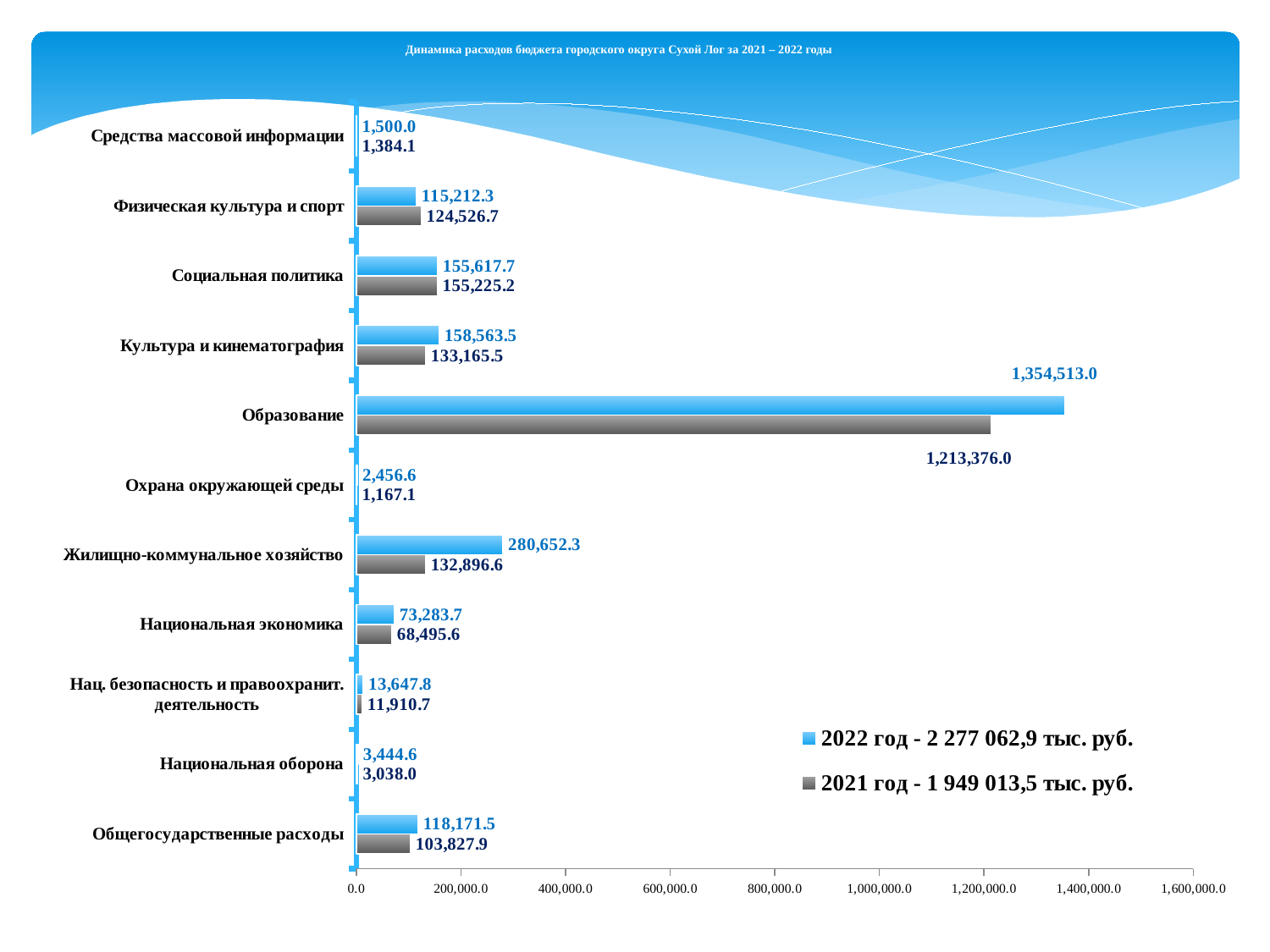
What is the 2022 value for Национальная оборона? 3,444.6 What is the 2021 value for Жилищно-коммунальное хозяйство? 132,896.6 Which category has the lowest 2021 value? Охрана окружающей среды How many categories are plotted on the chart? 11 What type of chart is shown on the slide? bar chart What total amount does the legend give for 2022 год? 2 277 062,9 тыс. руб. For Физическая культура и спорт, which year has the larger value, 2022 or 2021? 2021 What is the 2022 value for Образование? 1,354,513.0 How many series does the legend list? 2 What is the difference between the 2022 and 2021 values for Образование? 141,137.0 Which category has the highest 2022 value? Образование What is the difference between the 2022 and 2021 values for Жилищно-коммунальное хозяйство? 147,755.7